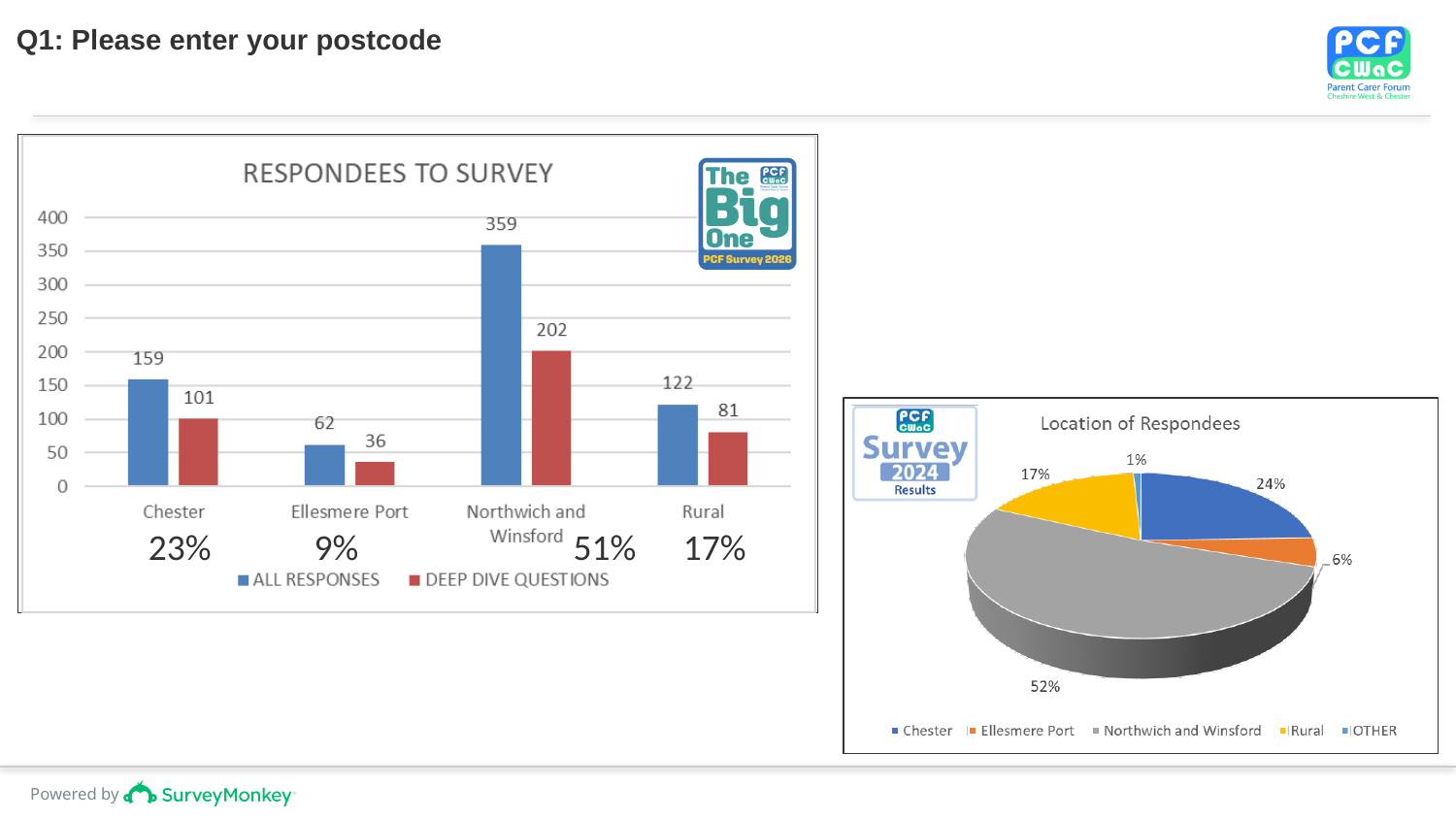
What kind of chart is 'Location of Respondees'? Pie chart In the 'RESPONDEES TO SURVEY' chart, which is larger: the ALL RESPONSES value for Chester or for Rural? Chester In the 'Location of Respondees' chart, what share of the pie is Ellesmere Port? 6% In the 'Location of Respondees' chart, which category has the smallest slice? OTHER In the 'RESPONDEES TO SURVEY' chart, what is the difference between the ALL RESPONSES and DEEP DIVE QUESTIONS values for Rural? 41 What kind of chart is 'RESPONDEES TO SURVEY'? Bar chart In the 'RESPONDEES TO SURVEY' chart, what is the ALL RESPONSES value for Northwich and Winsford? 359 In the 'Location of Respondees' chart, what share of the pie is Northwich and Winsford? 52% How many categories does the legend of the 'Location of Respondees' chart list? 5 In the 'RESPONDEES TO SURVEY' chart, what is the DEEP DIVE QUESTIONS value for Chester? 101 How many series does the legend of the 'RESPONDEES TO SURVEY' chart list? 2 In the 'RESPONDEES TO SURVEY' chart, which category has the lowest ALL RESPONSES value? Ellesmere Port